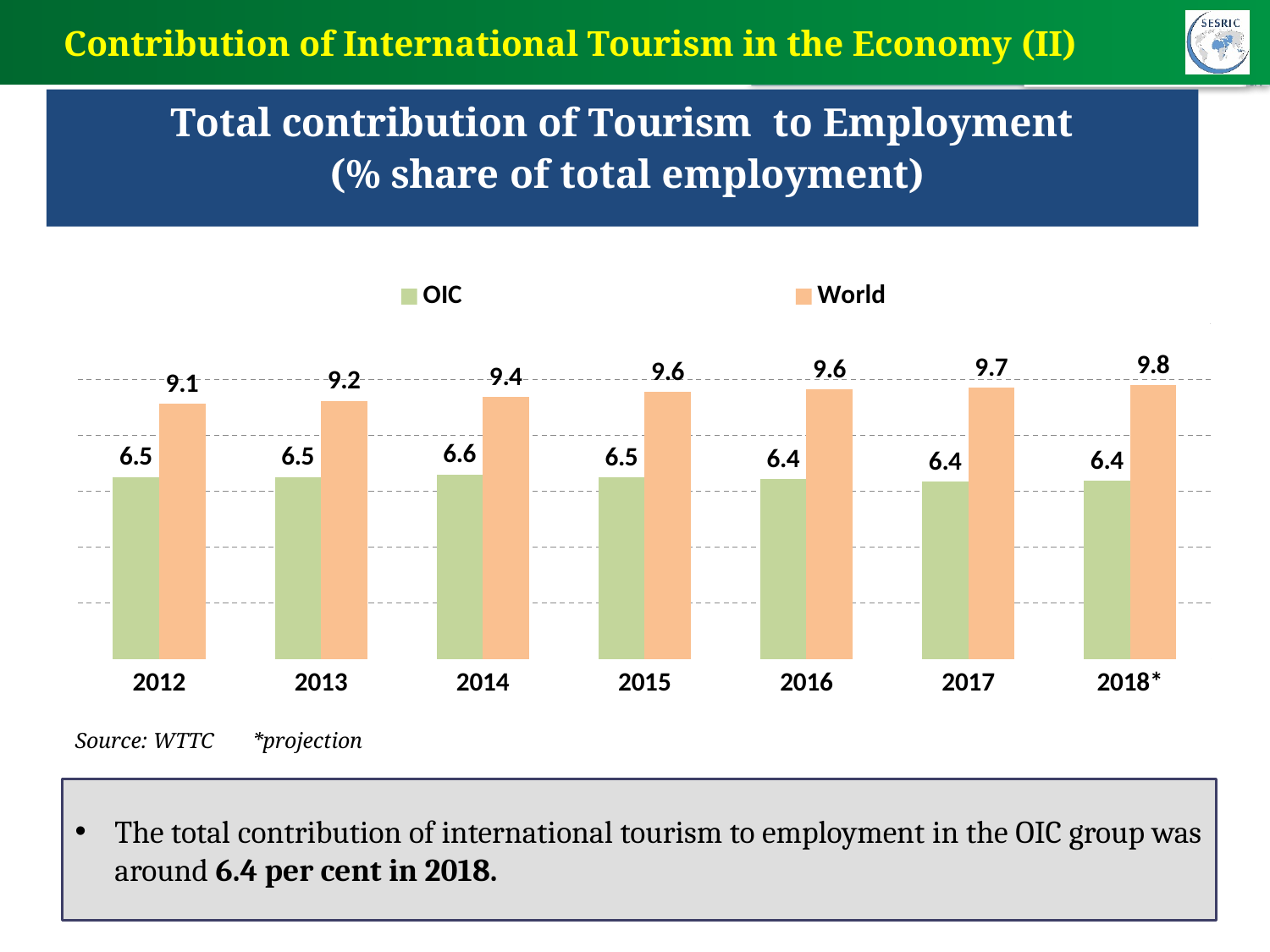
In which year is the World value lowest? 2012 What is the difference between the World and OIC values in 2018*? 3.4 In which year is the OIC value highest? 2014 Do the World values rise or fall from 2012 to 2018*? Rise How many series does the legend list? 2 Which is larger in 2015, the OIC value or the World value? World What is the OIC value for 2014? 6.6 What is the difference between the World values for 2012 and 2018*? 0.7 What is the World value for 2018*? 9.8 What kind of chart is shown? Bar chart What is the World value for 2012? 9.1 How many years are shown on the x axis? 7